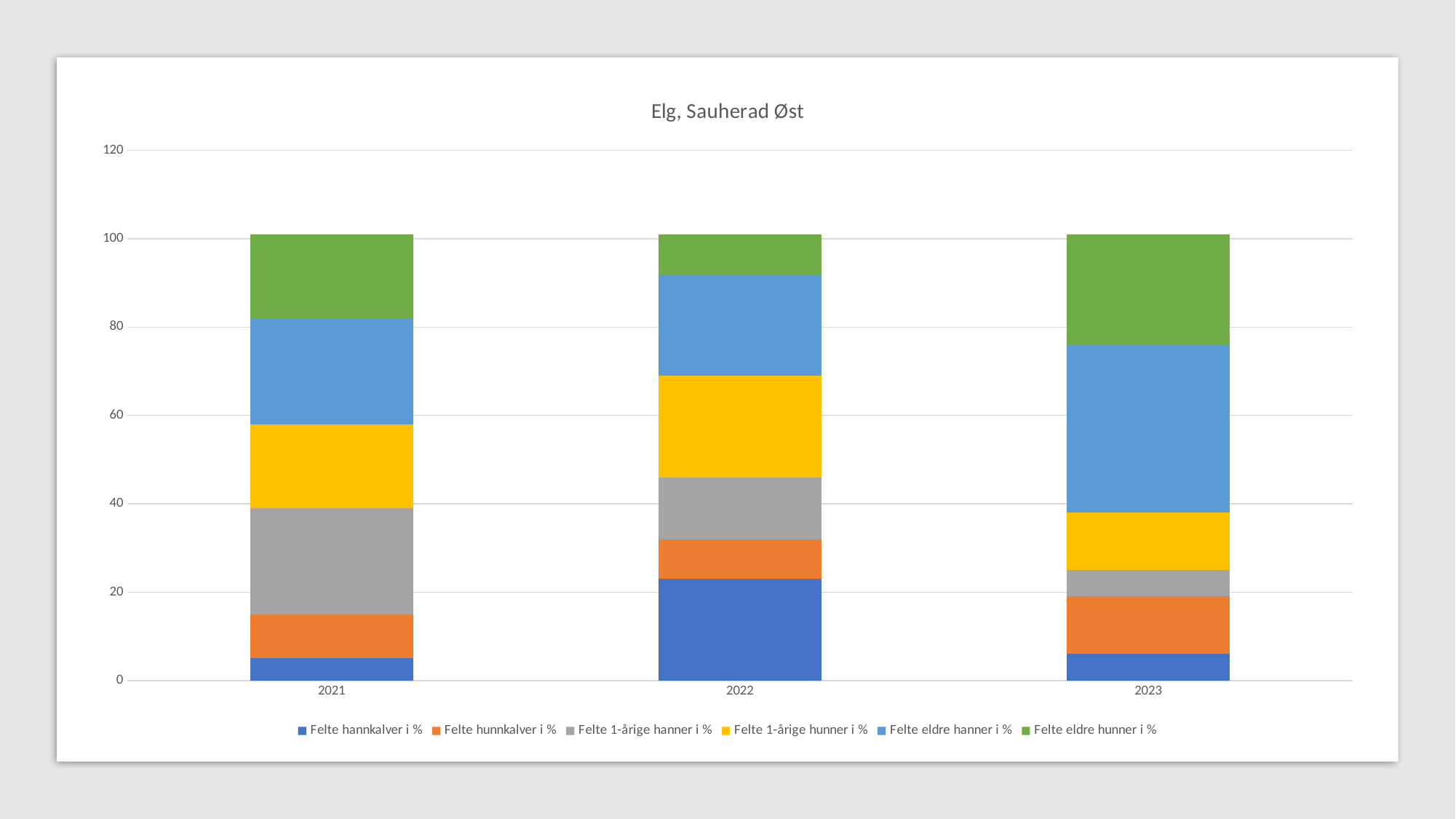
How many series does the legend list? 6 Which colour represents 'Felte 1-årige hunner i %' in the legend? Yellow In which year is the 'Felte eldre hunner i %' segment the smallest? 2022 In which year is the 'Felte hannkalver i %' segment the largest? 2022 What kind of chart is shown on the slide? Stacked bar chart Is the 'Felte eldre hanner i %' segment larger in 2023 or in 2021? 2023 What is the title of the chart? Elg, Sauherad Øst In which year is the 'Felte 1-årige hanner i %' segment the largest? 2021 In which year is the 'Felte 1-årige hanner i %' segment the smallest? 2023 Is the total height of the stacked bar for 2022 greater or less than 80? greater How many years are shown on the x axis of the chart? 3 In which year is the 'Felte eldre hanner i %' segment the largest? 2023